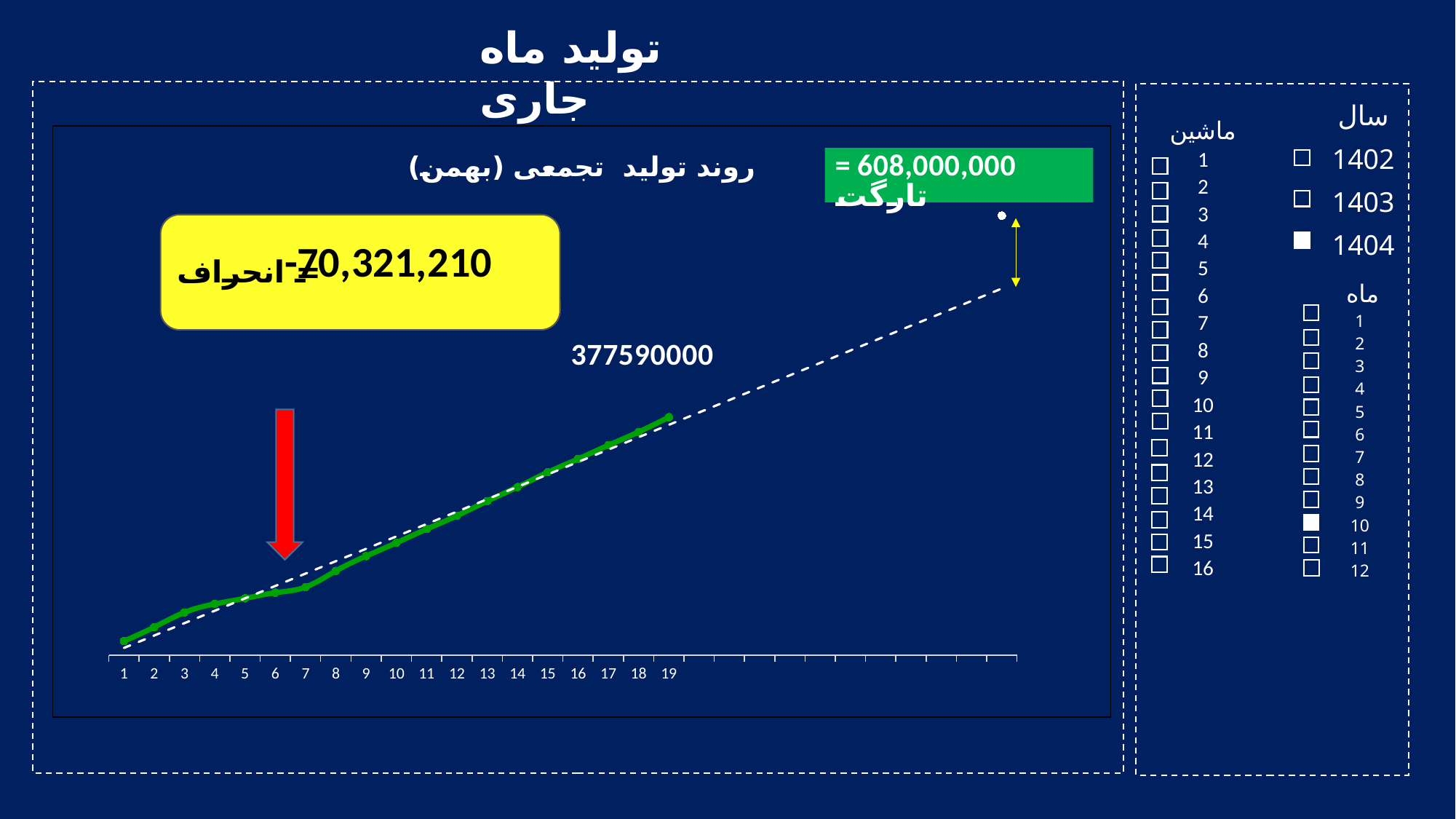
How many labeled points does the x axis show? 19 What deviation (انحراف) value is shown in the yellow box on the chart? -70,321,210 At which x-axis point does the green line have its lowest value? 1 At which x-axis point does the green line reach its highest value? 19 What is the title of the chart? روند تولید تجمعی (بهمن) At point 7, is the green line above or below the dashed target line? below What is the data label shown at point 19 on the green line? 377590000 What kind of chart is shown on the slide? line chart What colour is the solid line showing cumulative production? green Does the green line rise or fall along the x axis? rise What target value (تارگت) is shown in the green box on the chart? 608,000,000